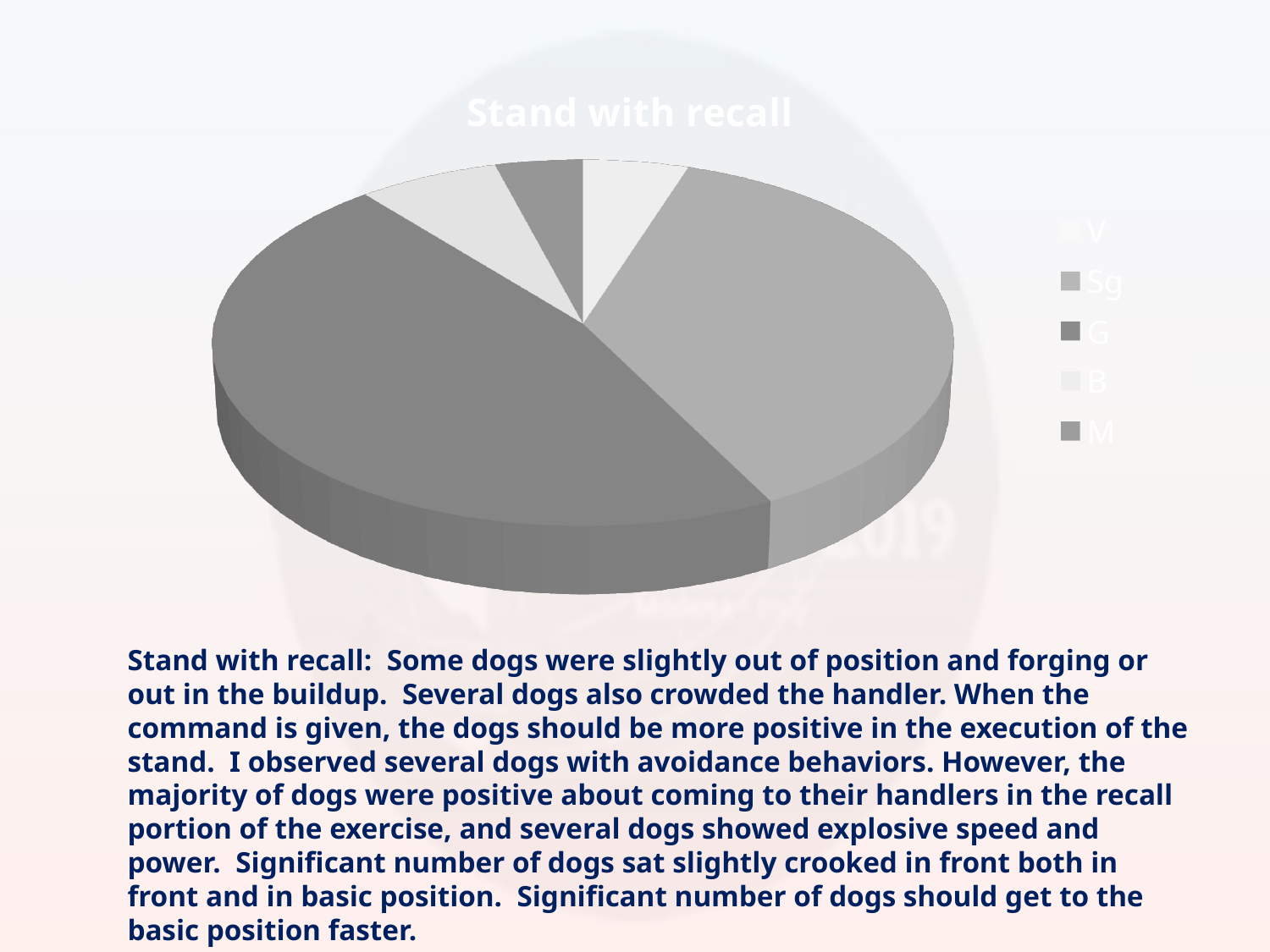
How many categories does the legend of the pie chart list? 5 Which category has the largest slice of the pie? G Which slice is larger, Sg or B? Sg What is the title of the chart? Stand with recall Which slice is larger, Sg or V? Sg Which slice is larger, G or Sg? G Which category is listed first in the legend? V What kind of chart is shown on the slide? pie chart